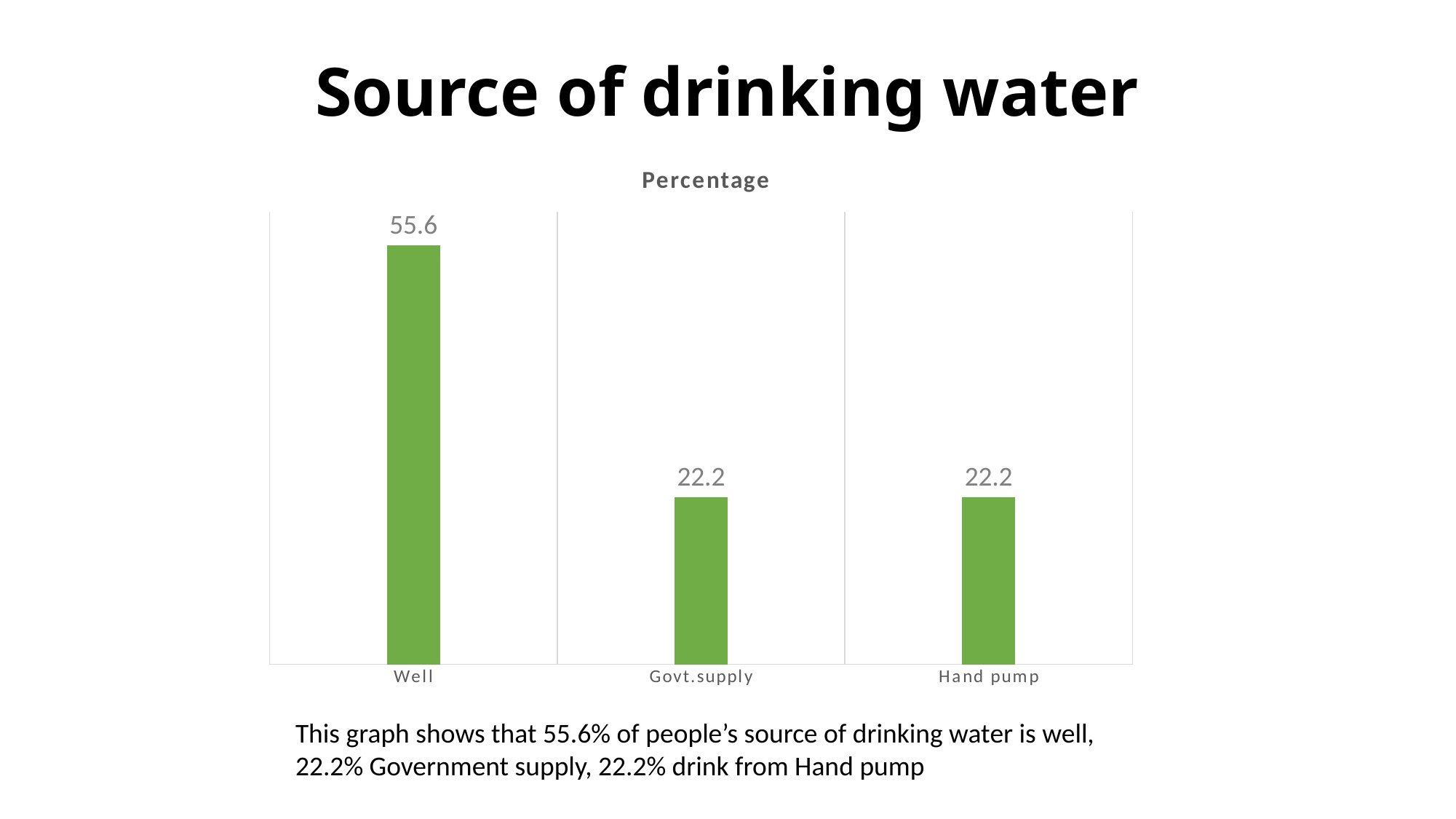
Which category has the highest value? Well How many categories are shown on the x axis? 3 What is the value for Hand pump? 22.2 What is the value for Govt.supply? 22.2 Which is larger, the value for Well or the value for Hand pump? Well What is the difference between the values for Well and Govt.supply? 33.4 What kind of chart is shown on the slide? Bar chart What colour are the bars in the chart? Green Do the values for Govt.supply and Hand pump differ? No, both are 22.2 What is the title of the chart? Percentage What is the value for Well? 55.6 What is the total of the values for Govt.supply and Hand pump? 44.4